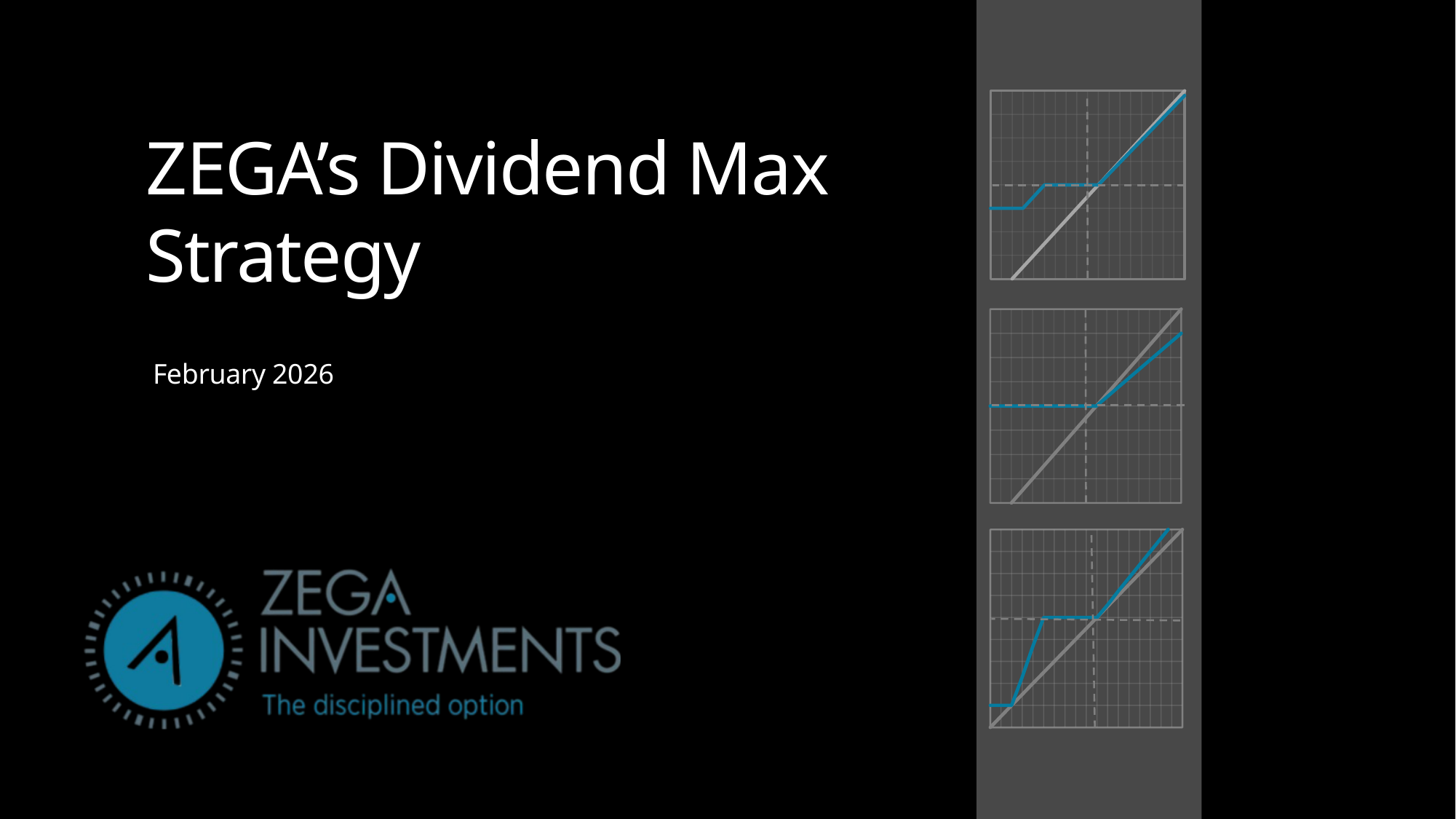
In the top chart on the right side of the slide, does the blue line overall rise or fall from left to right? rise In the middle chart on the right side of the slide, does the blue line rise or stay flat in the left half of the chart? stay flat How many small charts are shown on the right side of the slide? 3 In the bottom chart on the right side of the slide, does the blue line overall rise or fall from left to right? rise What colour is the non-grey line in the small charts on the right side of the slide? blue How many lines are plotted in each of the small charts on the right side of the slide? 2 What kind of chart are the three small charts on the right side of the slide? line chart